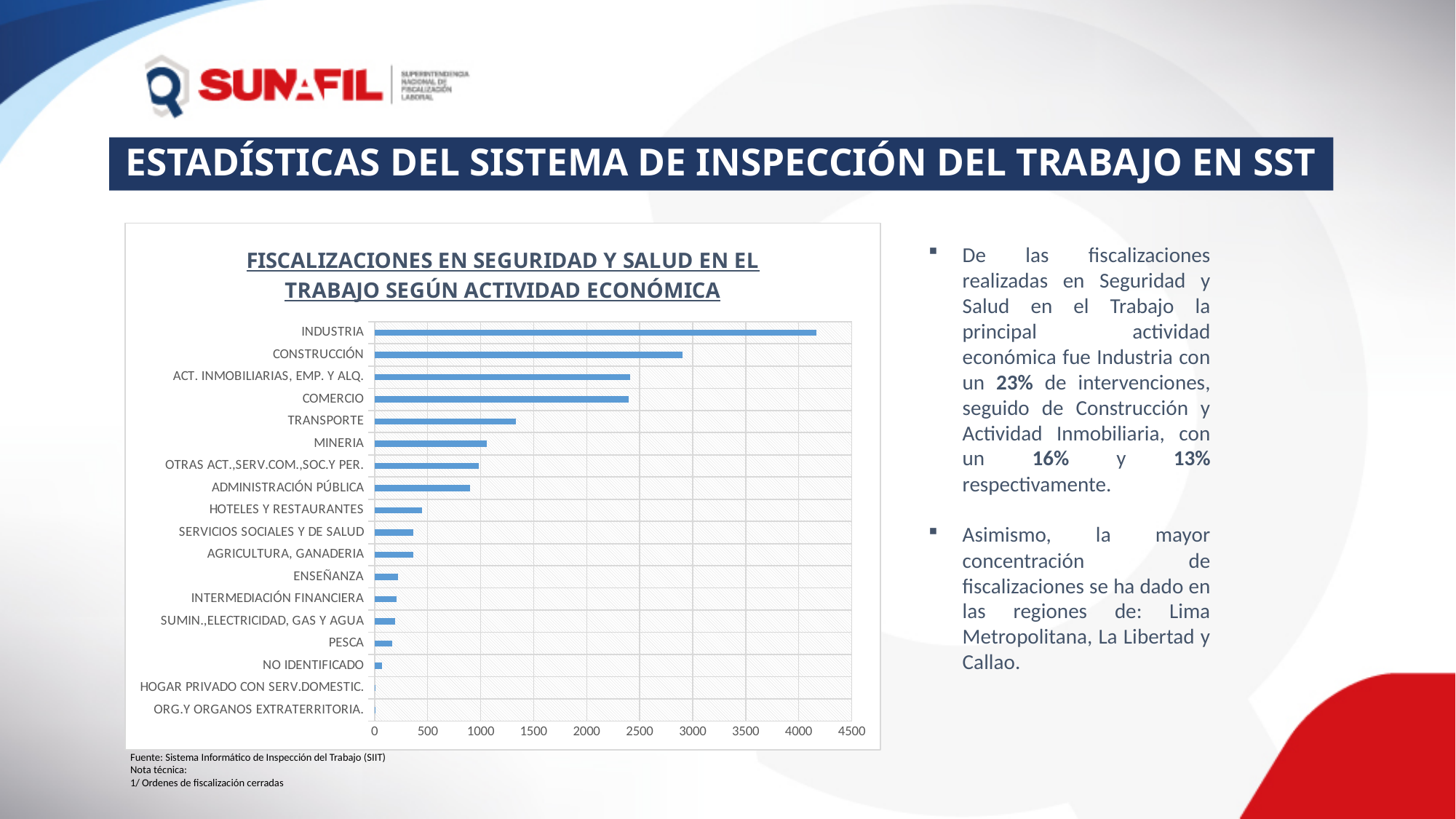
Is the value for CONSTRUCCIÓN greater or less than 3000? less Is the value for ADMINISTRACIÓN PÚBLICA greater or less than 1000? less Which has more fiscalizaciones, CONSTRUCCIÓN or TRANSPORTE? CONSTRUCCIÓN What is the title of the chart? FISCALIZACIONES EN SEGURIDAD Y SALUD EN EL TRABAJO SEGÚN ACTIVIDAD ECONÓMICA What is the maximum value shown on the horizontal axis of the chart? 4500 Which economic activity has the highest number of fiscalizaciones? INDUSTRIA What kind of chart is shown on the slide? Bar chart Is the value for INDUSTRIA greater or less than 4000? greater Which has more fiscalizaciones, COMERCIO or MINERIA? COMERCIO How many economic activity categories are plotted in the chart? 18